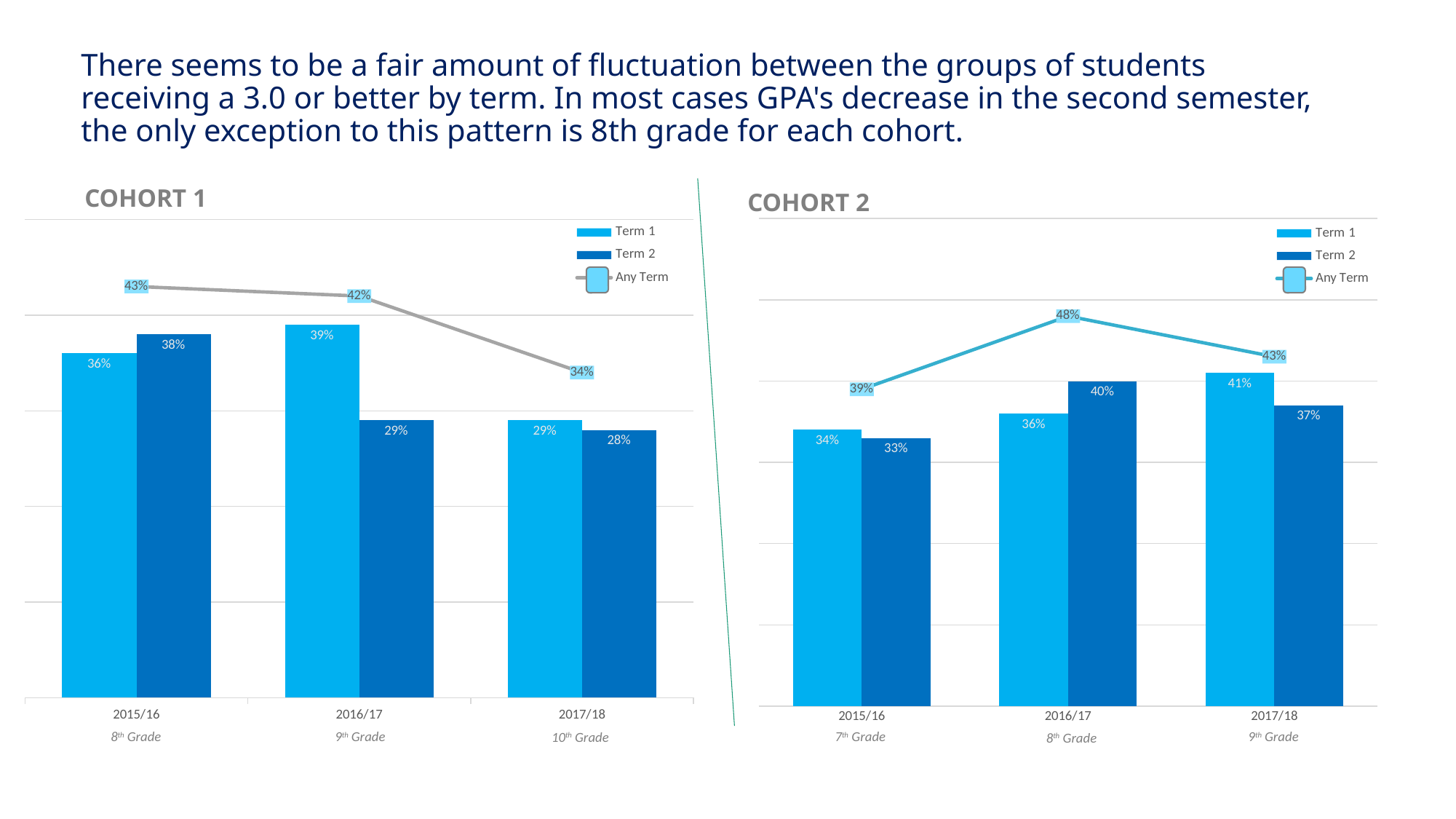
How many series does the legend of the COHORT 2 chart list? 3 What kind of chart is the COHORT 2 chart? Bar chart with a line In the COHORT 2 chart, what is the difference between the Term 1 and Term 2 values for 2017/18? 4% In the COHORT 1 chart, which year has the lowest Term 2 value? 2017/18 In the COHORT 2 chart, which year has the highest Any Term value? 2016/17 In the COHORT 1 chart, what is the Any Term value for 2017/18? 34% In the COHORT 1 chart, what is the Term 1 value for 2016/17? 39% In the COHORT 2 chart, what is the Term 2 value for 2016/17? 40% In the COHORT 1 chart, does the Any Term line rise or fall from 2015/16 to 2017/18? fall How many years are shown on the x axis of the COHORT 1 chart? 3 In the COHORT 1 chart, which is larger for 2015/16, Term 1 or Term 2? Term 2 In the COHORT 2 chart, which grade label appears under 2015/16? 7th Grade